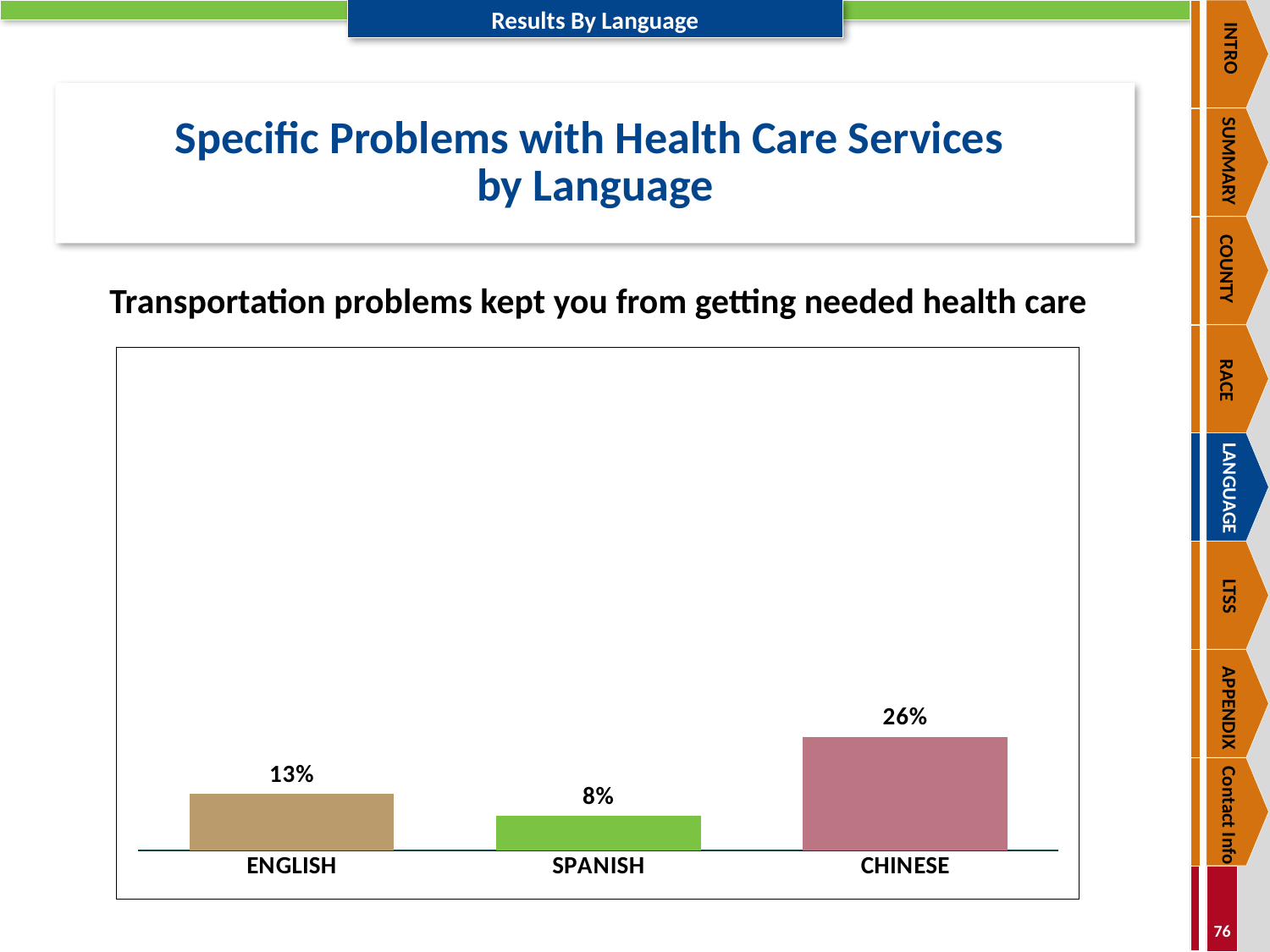
Which is larger, the value for CHINESE or the value for ENGLISH? CHINESE What survey item does the chart report on? Transportation problems kept you from getting needed health care Which language group has the lowest value? SPANISH What is the value for CHINESE? 26% Which language group has the highest value? CHINESE What is the difference between the values for CHINESE and ENGLISH? 13% What is the value for SPANISH? 8% What is the value for ENGLISH? 13% Which is larger, the value for ENGLISH or the value for SPANISH? ENGLISH How many language categories are shown in the chart? 3 What kind of chart is shown on the slide? Bar chart What is the difference between the values for ENGLISH and SPANISH? 5%